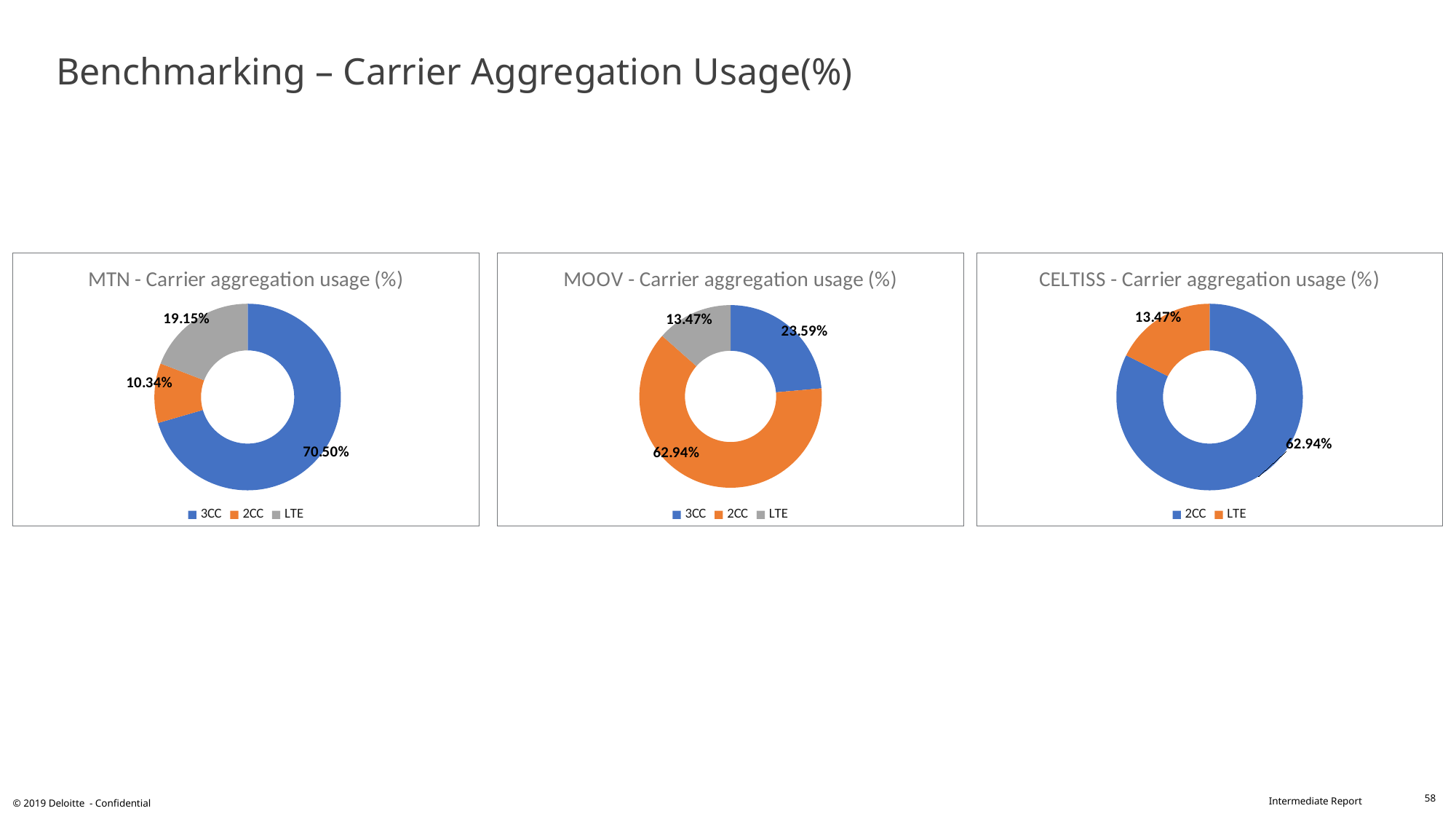
In the MOOV - Carrier aggregation usage (%) chart, which is larger, 3CC or LTE? 3CC In the MTN - Carrier aggregation usage (%) chart, what is the value for 2CC? 10.34% In the MOOV - Carrier aggregation usage (%) chart, which category has the smallest share? LTE In the MTN - Carrier aggregation usage (%) chart, what is the value for LTE? 19.15% In the MOOV - Carrier aggregation usage (%) chart, what is the value for 3CC? 23.59% How many categories does the legend of the CELTISS - Carrier aggregation usage (%) chart list? 2 In the MTN - Carrier aggregation usage (%) chart, which category has the largest share? 3CC In the CELTISS - Carrier aggregation usage (%) chart, what is the value for LTE? 13.47% What kind of chart is the MOOV - Carrier aggregation usage (%) chart? Doughnut chart In the MTN - Carrier aggregation usage (%) chart, what is the difference between the 3CC and LTE values? 51.35% In the MOOV - Carrier aggregation usage (%) chart, what is the value for 2CC? 62.94% In the MTN - Carrier aggregation usage (%) chart, what is the value for 3CC? 70.50%